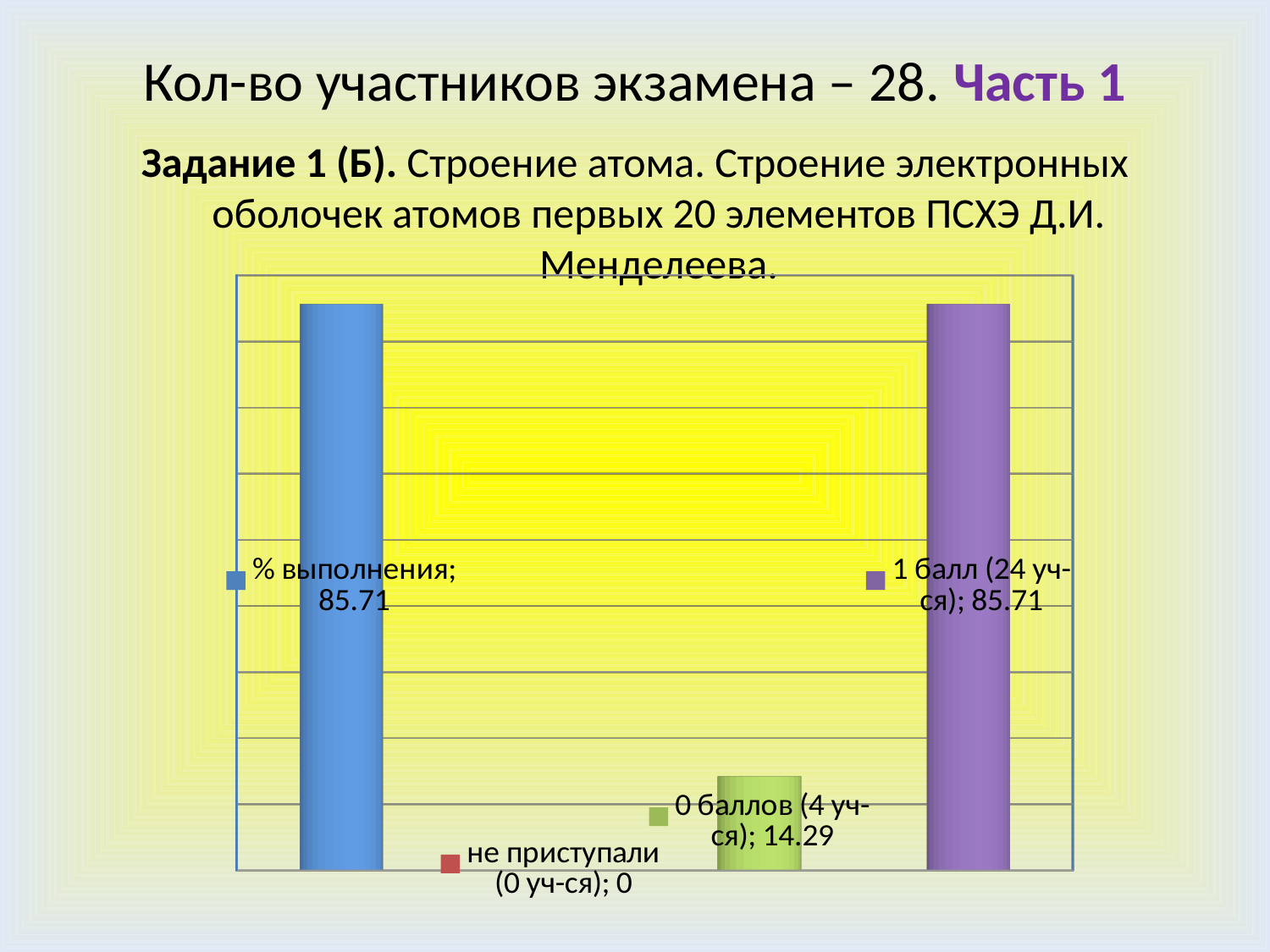
Which category has the lowest value in the chart? не приступали (0 уч-ся) What is the value shown for "1 балл (24 уч-ся)"? 85.71 What colour is the bar for "% выполнения"? blue What is the value shown for "0 баллов (4 уч-ся)"? 14.29 What is the value shown for "не приступали (0 уч-ся)"? 0 How many bars (categories) are plotted in the chart? 4 How many students scored 1 балл according to the chart label? 24 What colour is the bar for "0 баллов (4 уч-ся)"? green Which is larger: the value for "0 баллов (4 уч-ся)" or the value for "1 балл (24 уч-ся)"? 1 балл (24 уч-ся) What is the value shown for "% выполнения"? 85.71 What kind of chart is shown on the slide? bar chart What is the difference between the values for "1 балл (24 уч-ся)" and "0 баллов (4 уч-ся)"? 71.42